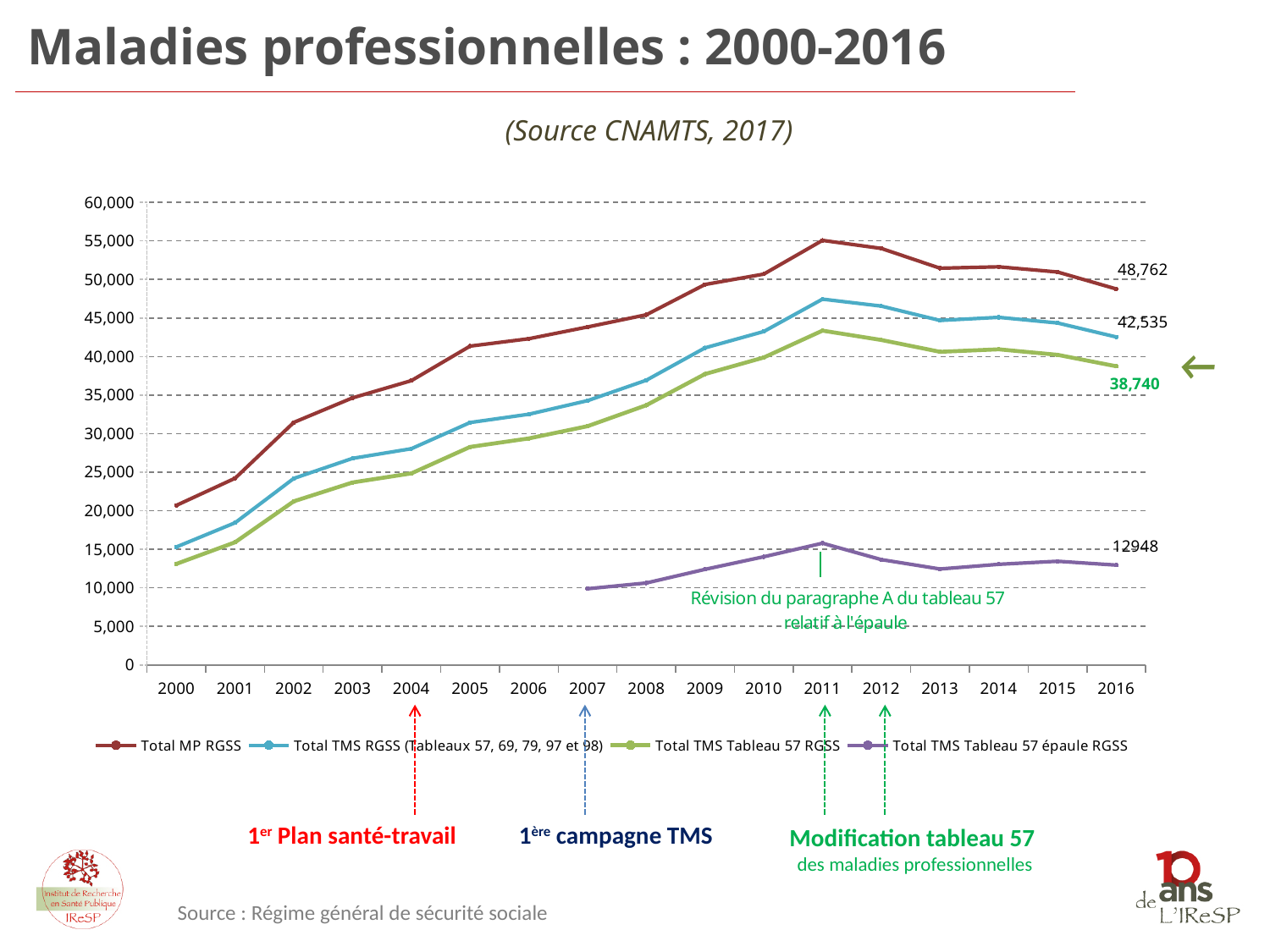
In which year does the Total TMS Tableau 57 épaule RGSS series begin? 2007 What is the difference between Total MP RGSS and Total TMS RGSS in 2016? 6,227 What kind of chart is shown on the slide? Line chart Does the Total MP RGSS series rise or fall between 2011 and 2016? Fall Is the value of Total MP RGSS in 2000 greater or less than 25,000? less What is the value of Total MP RGSS in 2016? 48,762 How many years are shown on the x axis? 17 How many series does the legend list? 4 What is the value of Total TMS RGSS (Tableaux 57, 69, 79, 97 et 98) in 2016? 42,535 What is the value of Total TMS Tableau 57 épaule RGSS in 2016? 12948 What is the value of Total TMS Tableau 57 RGSS in 2016? 38,740 In which year does the Total MP RGSS series reach its highest value? 2011